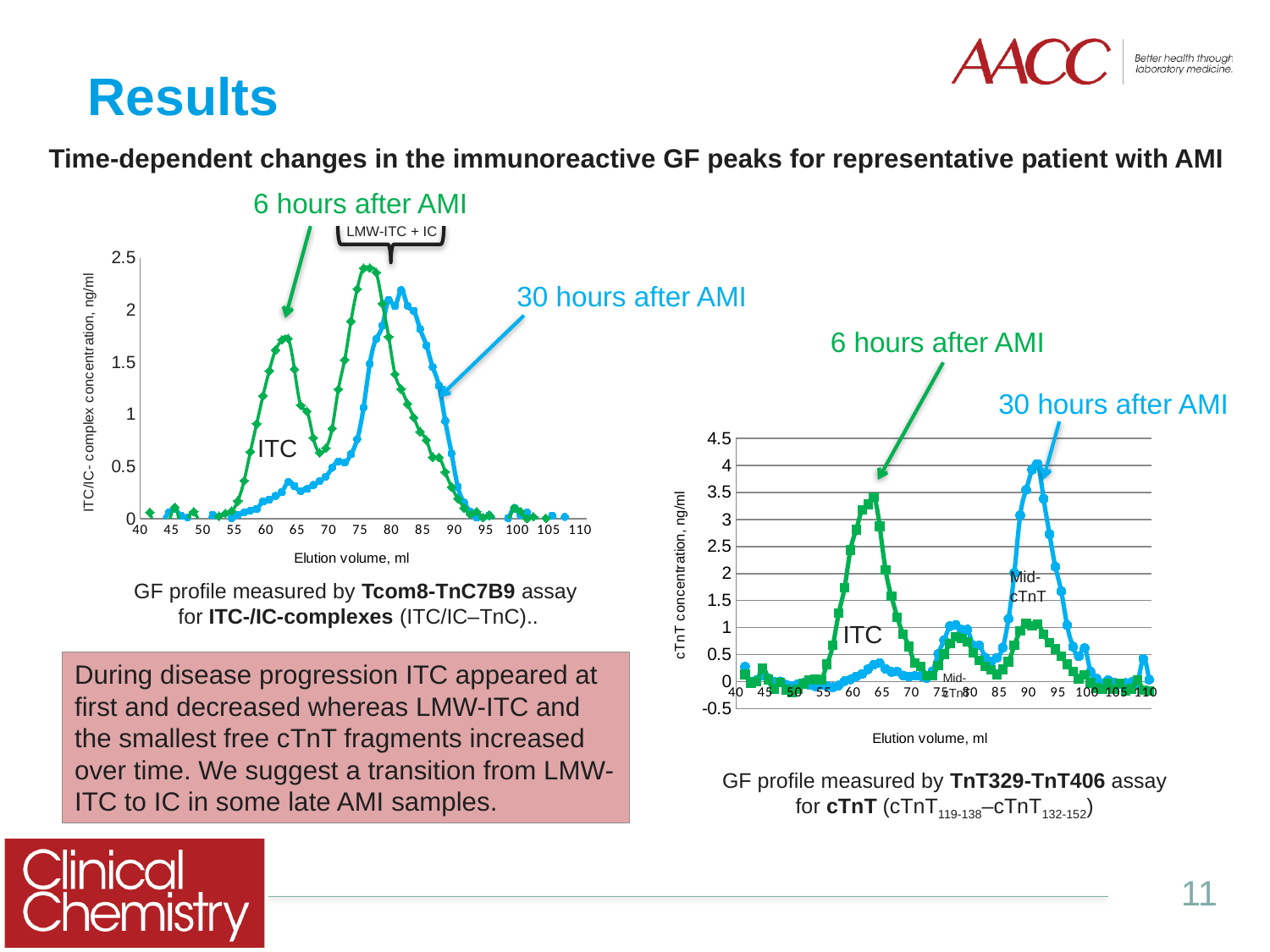
In the right chart, which series has the higher peak, 6 hours after AMI or 30 hours after AMI? 30 hours after AMI In the left chart, how many data series are plotted? 2 In the left chart, at about 63 ml, which series has the larger value, 6 hours after AMI or 30 hours after AMI? 6 hours after AMI What kind of chart is the right chart (cTnT concentration)? line chart In the left chart, is the value of the 30 hours after AMI series at about 63 ml greater or less than 0.5? less In the right chart, is the peak value of the 30 hours after AMI series near 90 ml greater or less than 3.5? greater In the right chart, how many data series are plotted? 2 In the left chart, what is the label of the x axis? Elution volume, ml What kind of chart is the left chart (ITC/IC-complex concentration)? line chart In the right chart, is the peak value of the 6 hours after AMI series near 63 ml greater or less than 3? greater In the right chart, what is the label of the y axis? cTnT concentration, ng/ml